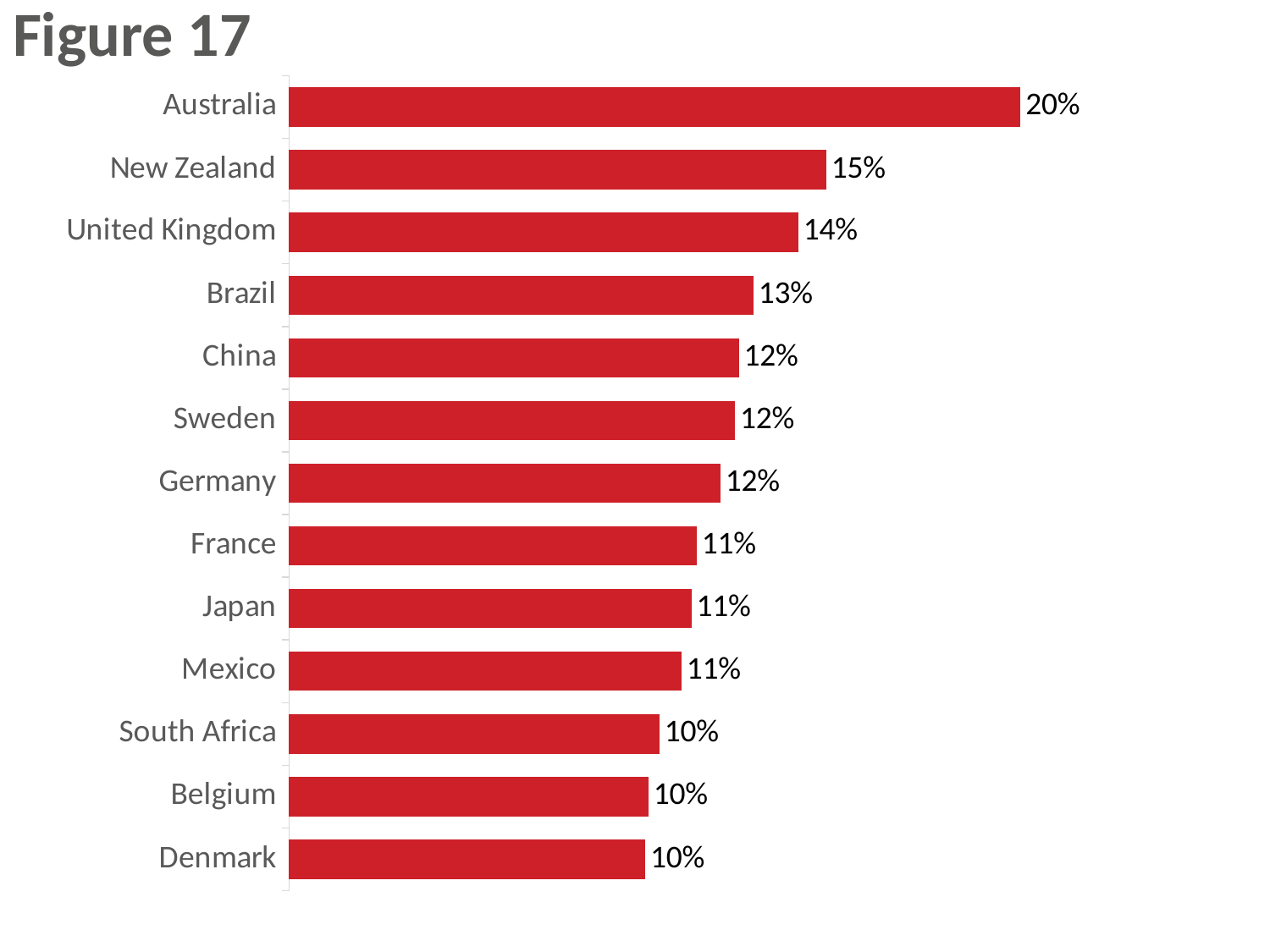
What kind of chart is shown on the slide? Bar chart Which has a larger value, Mexico or China? China How many countries are shown in the chart? 13 What is the title of the chart? Figure 17 What is the value for Australia? 20% What is the value for South Africa? 10% Which has a larger value, New Zealand or Brazil? New Zealand Which country has the highest value? Australia What is the difference between the values for Australia and New Zealand? 5% What is the difference between the values for United Kingdom and Denmark? 4% What is the value for Brazil? 13% What is the value for United Kingdom? 14%